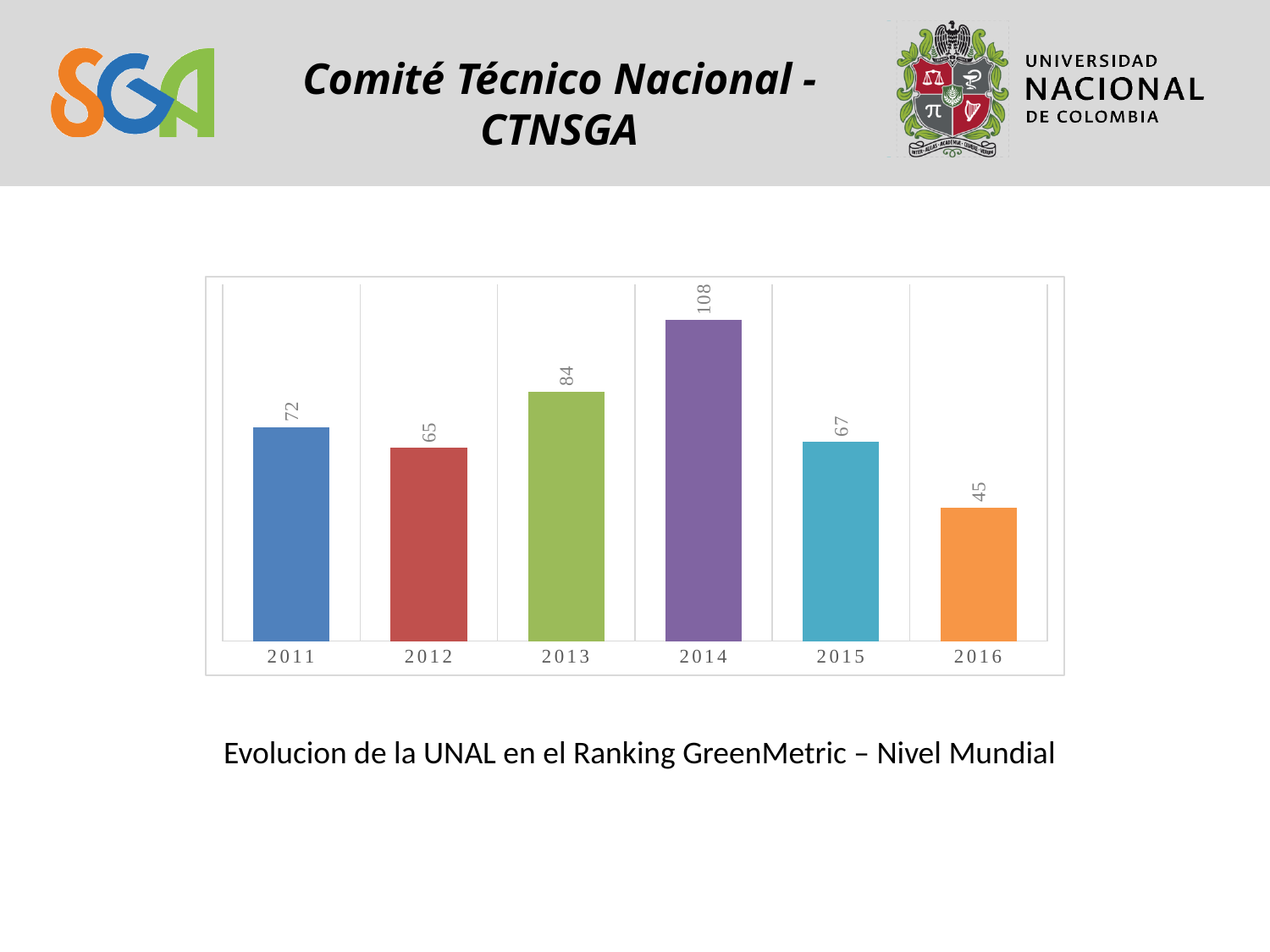
How many years are shown on the x axis? 6 What is the value for 2016? 45 What is the value for 2011? 72 What is the value for 2014? 108 Do the values rise or fall from 2014 to 2016? fall What kind of chart is shown on the slide? bar chart Which year has the lowest value? 2016 What is the caption below the chart? Evolucion de la UNAL en el Ranking GreenMetric – Nivel Mundial What is the difference between the values for 2014 and 2013? 24 Which year has the highest value? 2014 What is the difference between the values for 2011 and 2012? 7 Which is larger, the value for 2013 or the value for 2015? 2013